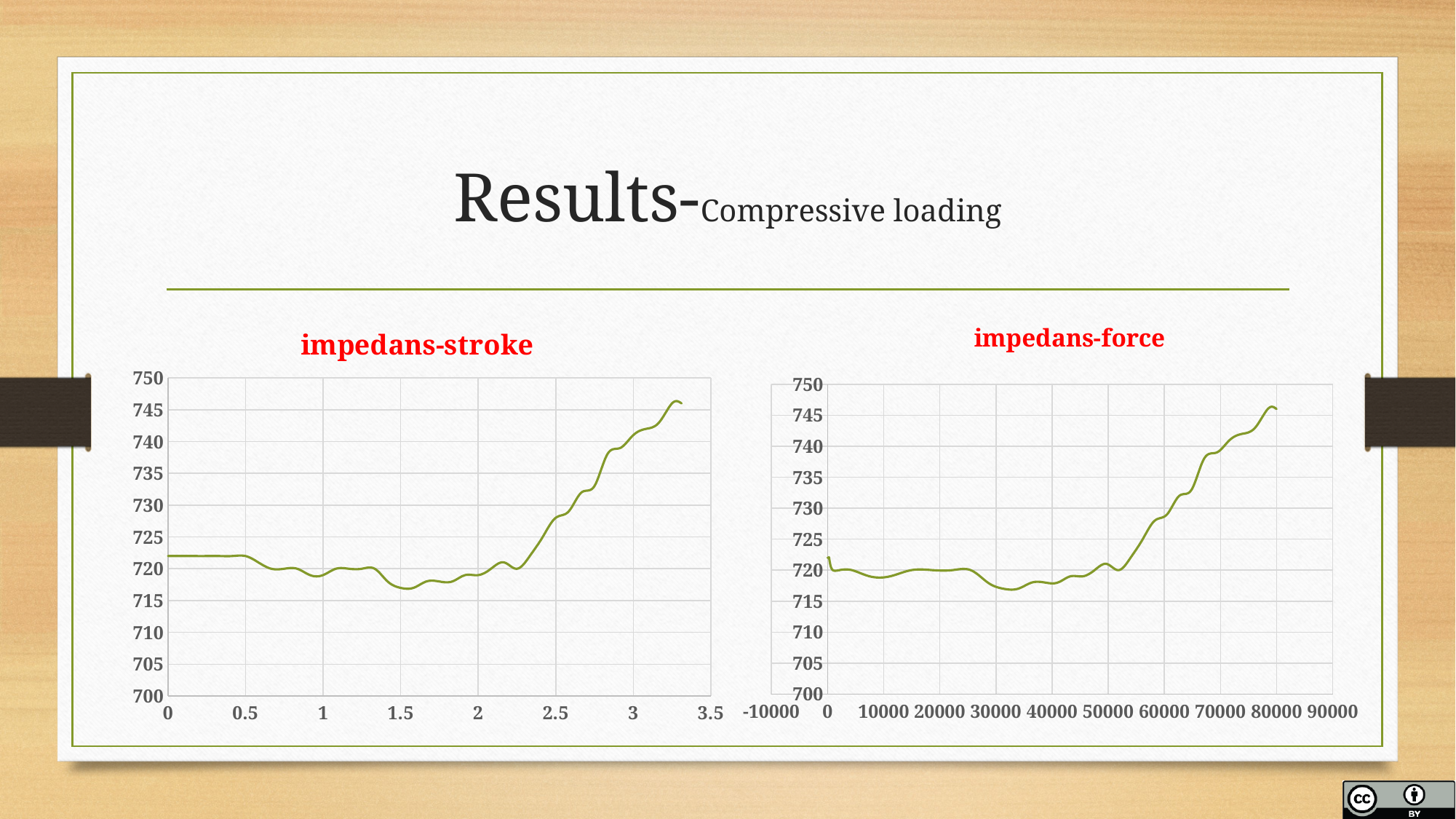
What kind of chart is the impedans-stroke chart? line chart In the impedans-force chart, is the value at x = 70000 greater or less than 735? greater How many charts are shown on the slide? 2 What is the title of the chart on the right of the slide? impedans-force What is the title of the chart on the left of the slide? impedans-stroke In the impedans-force chart, does the line overall rise or fall from the left end to the right end of the x axis? rise In the impedans-force chart, is the value at x = 30000 greater or less than 720? less In the impedans-stroke chart, is the value at x = 1.5 greater or less than 720? less In the impedans-stroke chart, does the line overall rise or fall from the left end to the right end of the x axis? rise What kind of chart is the impedans-force chart? line chart